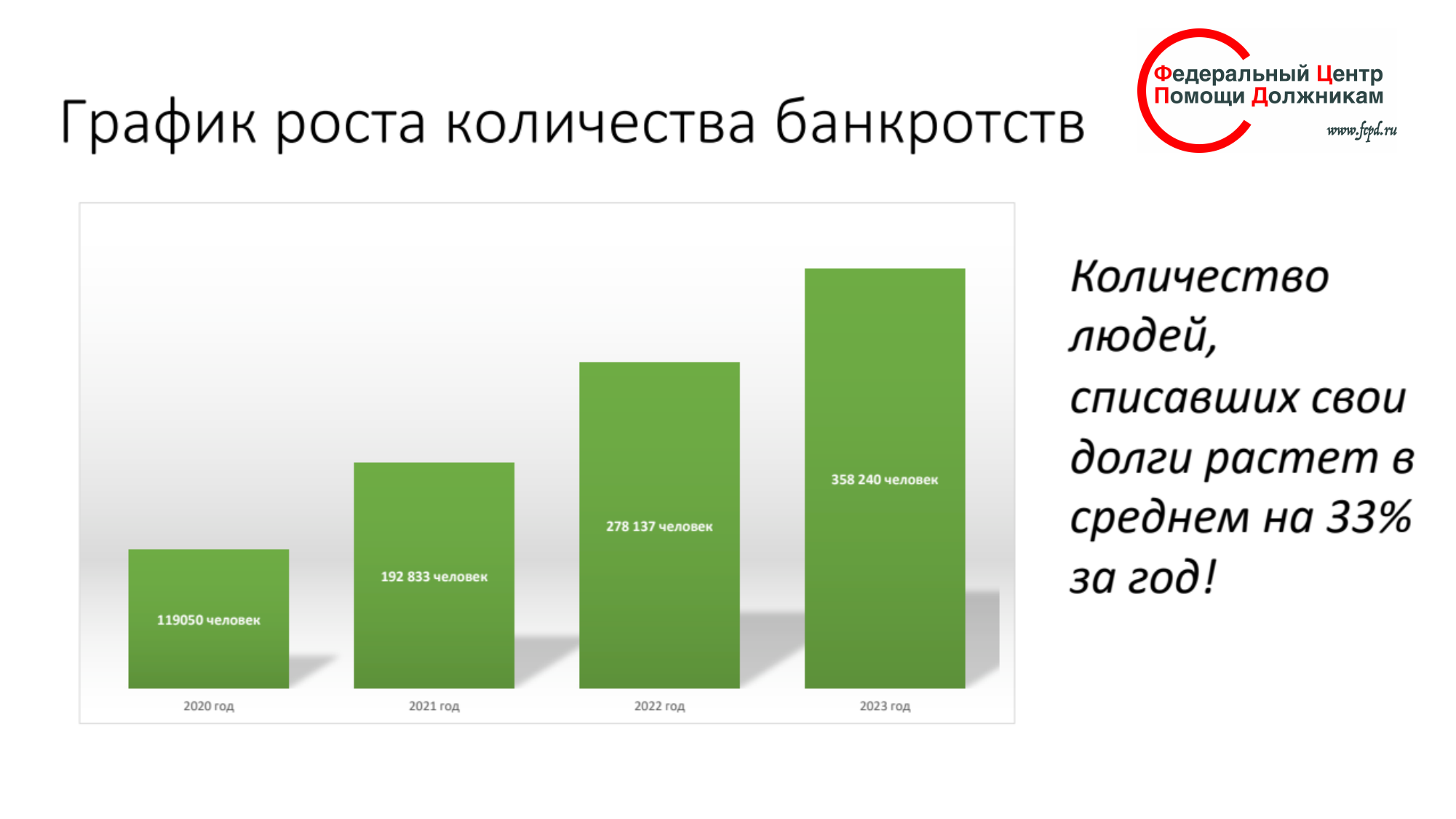
What is the difference between the values for 2023 год and 2022 год? 80 103 человек Which year has the lowest value? 2020 год Which is larger, the value for 2021 год or the value for 2022 год? 2022 год What is the value shown for 2023 год? 358 240 человек What kind of chart is shown on the slide? Bar chart What is the difference between the values for 2021 год and 2020 год? 73 783 человек What is the value shown for 2020 год? 119050 человек Which year has the highest value? 2023 год Do the values rise or fall from 2020 год to 2023 год? Rise What is the value shown for 2021 год? 192 833 человек How many years (bars) are shown in the chart? 4 What is the value shown for 2022 год? 278 137 человек